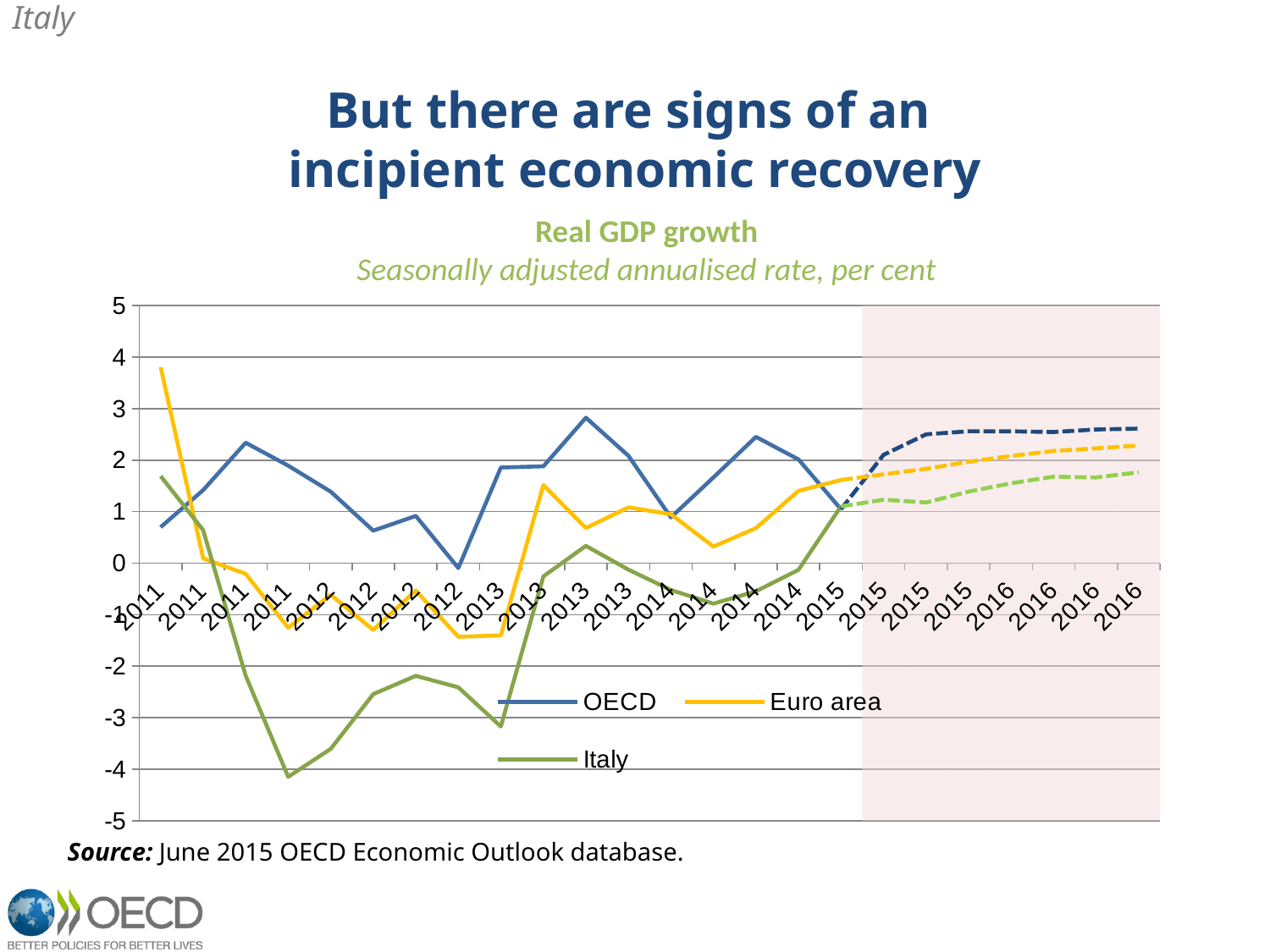
Which series has the highest value at the first point in 2011? Euro area What is the title of the chart? Real GDP growth Is the lowest value of the Italy series greater or less than -3? less Which series reaches the lowest value anywhere on the chart? Italy Which series has the highest value at the last point in 2016? OECD Which series has the lowest value at the last point in 2016? Italy At the last point in 2016, is the OECD value or the Italy value larger? OECD What are the three series named in the legend? OECD, Euro area, Italy How many series does the legend list? 3 Is the Euro area value at the first point in 2011 greater or less than 3? greater What kind of chart is shown on the slide? line chart Is the OECD value at the last point in 2016 greater or less than 2? greater